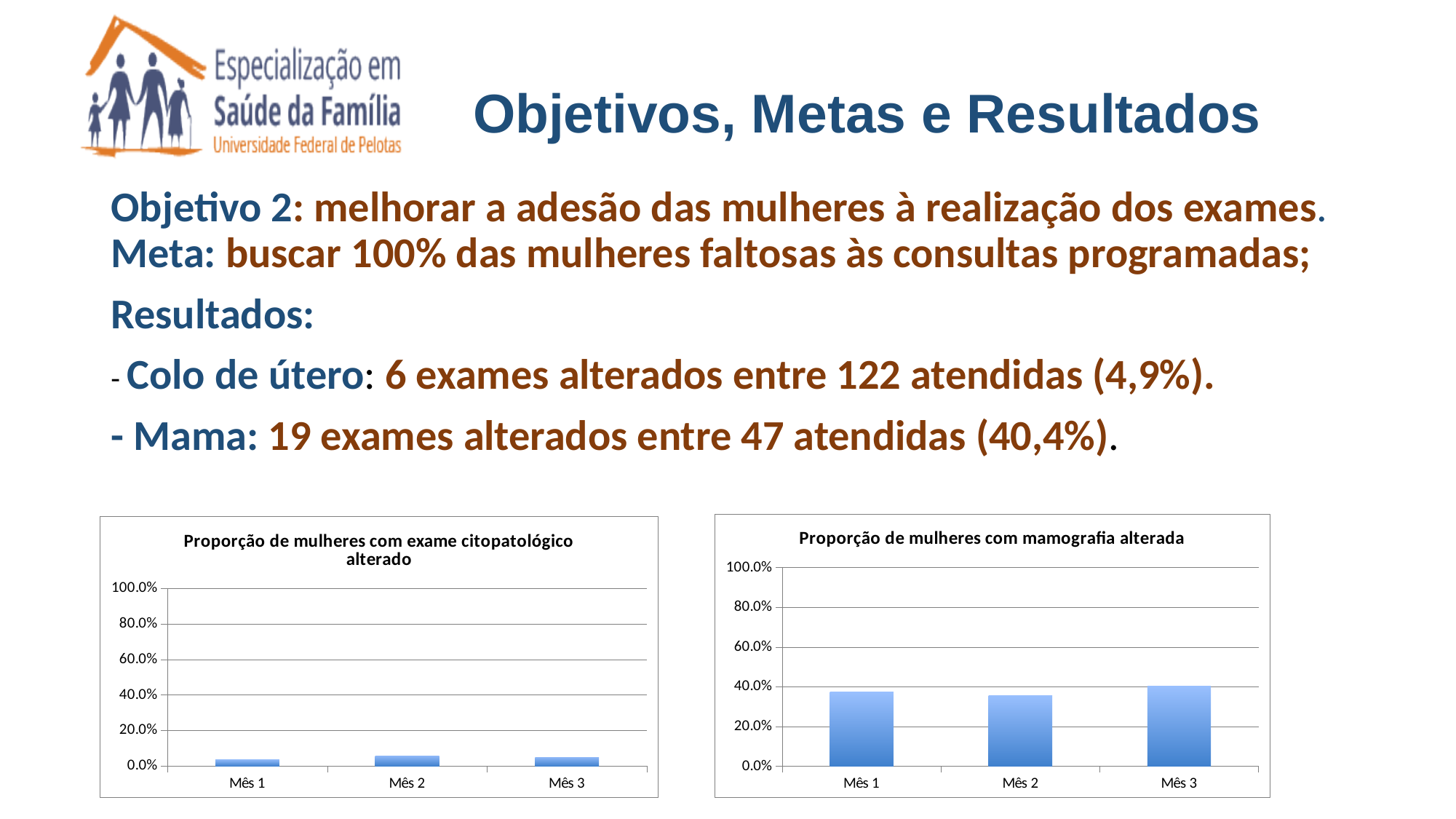
In the 'Proporção de mulheres com mamografia alterada' chart, is the value for Mês 2 greater or less than 40.0%? less In the 'Proporção de mulheres com mamografia alterada' chart, is the value for Mês 1 greater or less than 20.0%? greater What kind of chart is the 'Proporção de mulheres com exame citopatológico alterado' chart? bar chart In the 'Proporção de mulheres com mamografia alterada' chart, is the value for Mês 3 larger or smaller than the value for Mês 2? larger How many bars are plotted in the 'Proporção de mulheres com mamografia alterada' chart? 3 What is the highest tick value shown on the y axis of the 'Proporção de mulheres com exame citopatológico alterado' chart? 100.0% In the 'Proporção de mulheres com mamografia alterada' chart, which month has the highest value? Mês 3 In the 'Proporção de mulheres com mamografia alterada' chart, which month has the lowest value? Mês 2 What kind of chart is the 'Proporção de mulheres com mamografia alterada' chart? bar chart How many categories are shown on the x axis of the 'Proporção de mulheres com exame citopatológico alterado' chart? 3 In the 'Proporção de mulheres com exame citopatológico alterado' chart, is the value for Mês 2 greater or less than 20.0%? less What is the title of the chart on the right side of the slide? Proporção de mulheres com mamografia alterada